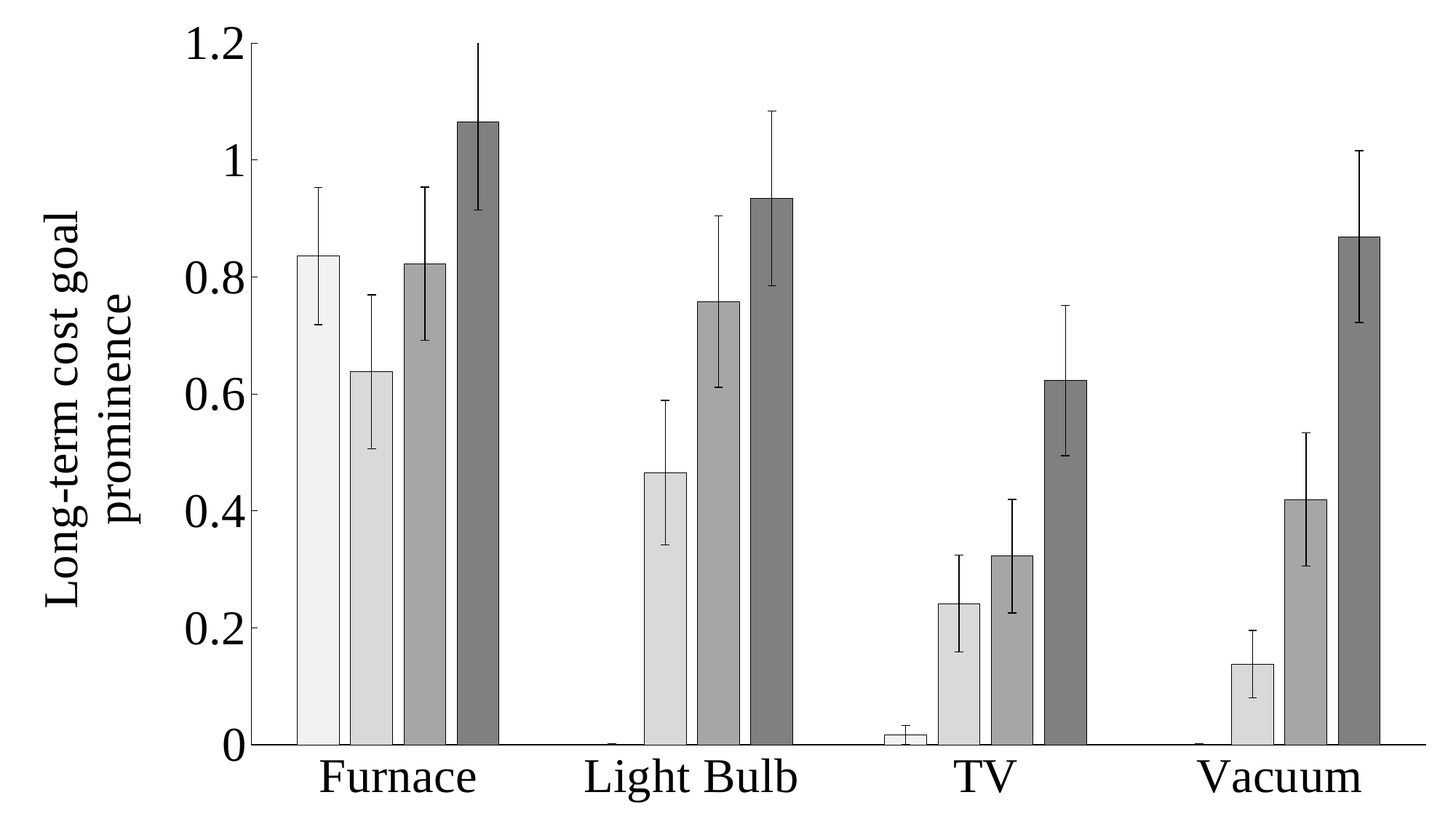
Is the value of the lightest (first) bar for Furnace greater or less than 0.6? greater What is the highest tick value shown on the y axis? 1.2 Which category has the tallest darkest (fourth) bar? Furnace Is the value of the darkest bar for TV greater or less than 0.8? less For TV, which is taller: the third bar or the fourth bar? the fourth bar What kind of chart is shown on the slide? bar chart How many bars are plotted for each category? 4 Which category has the shortest darkest (fourth) bar? TV Is the value of the darkest bar for Furnace greater or less than 1? greater How many categories are shown on the x axis? 4 What is the label of the y axis? Long-term cost goal prominence